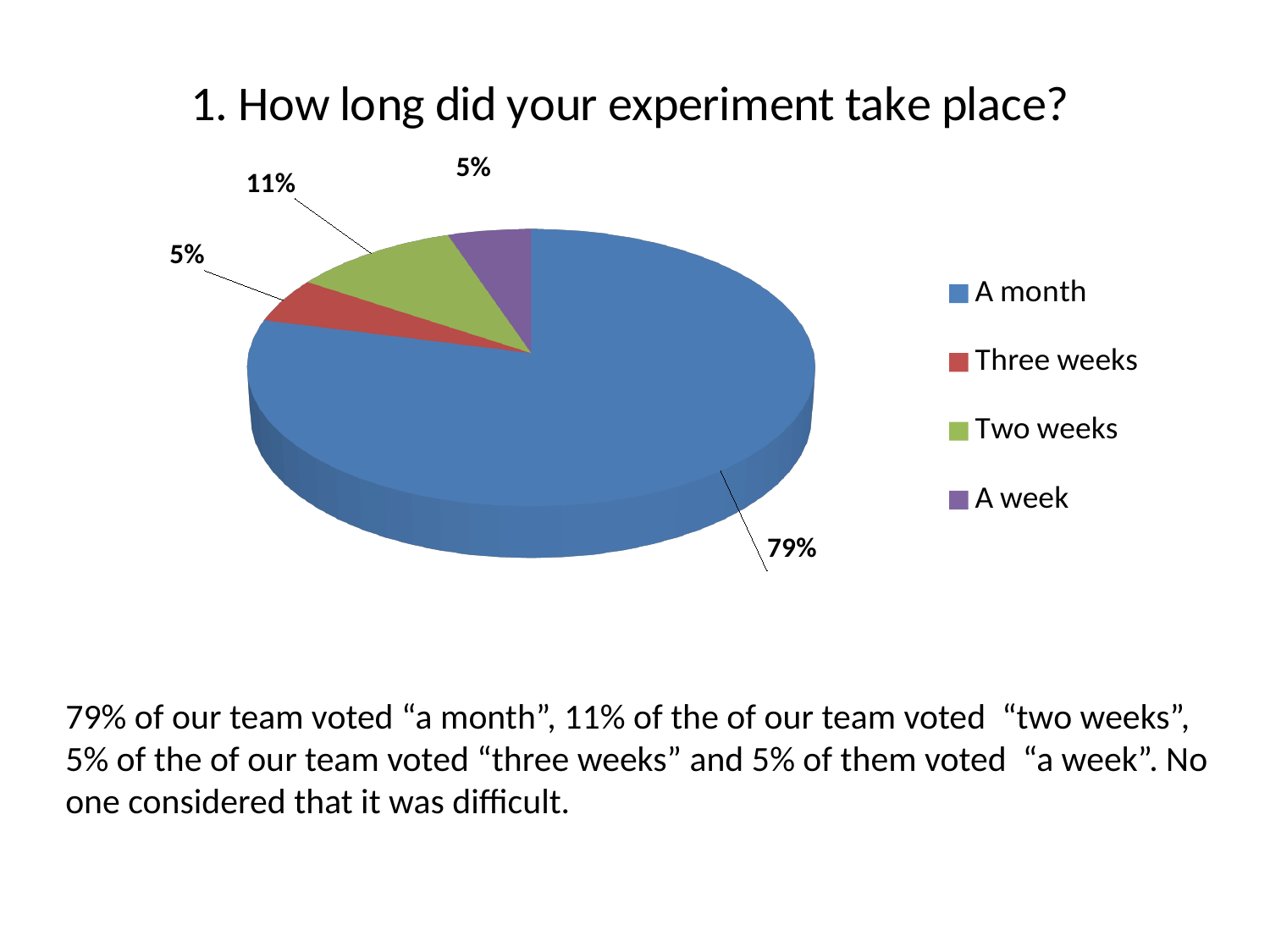
Which category has the largest slice of the pie? A month What share of the pie does "A week" take? 5% What share of the pie does "Two weeks" take? 11% What colour is the slice for "Two weeks"? Green What is the difference in percentage points between "A month" and "Two weeks"? 68 What is the title of the chart? 1. How long did your experiment take place? What is the difference in percentage points between "Two weeks" and "A week"? 6 What kind of chart is shown on the slide? Pie chart Which is larger, the slice for "Two weeks" or the slice for "Three weeks"? Two weeks How many categories does the pie chart show? 4 What share of the pie does "Three weeks" take? 5%